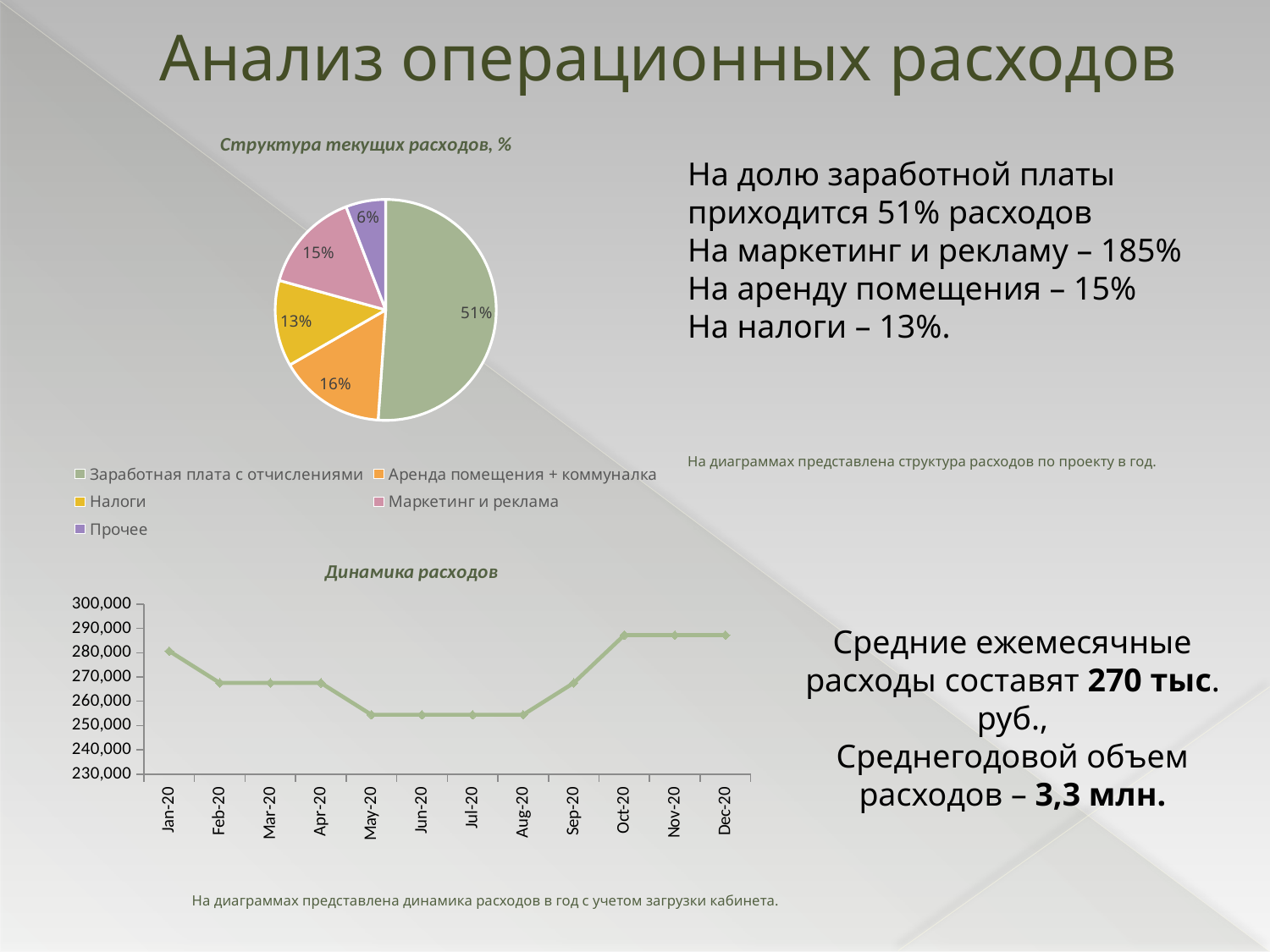
In the chart 'Динамика расходов', how many months are plotted on the x axis? 12 In the pie chart 'Структура текущих расходов, %', which category has the largest share? Заработная плата с отчислениями In the pie chart 'Структура текущих расходов, %', how many categories does the legend list? 5 What kind of chart is 'Динамика расходов'? Line chart In the chart 'Динамика расходов', is the value for Oct-20 greater or less than 280,000? greater In the chart 'Динамика расходов', is the value for May-20 greater or less than 260,000? less In the chart 'Динамика расходов', is the value for Dec-20 higher or lower than the value for Jul-20? higher In the pie chart 'Структура текущих расходов, %', which category has the smallest share? Прочее In the pie chart 'Структура текущих расходов, %', what is the difference between the shares of 'Аренда помещения + коммуналка' and 'Налоги'? 3% In the pie chart 'Структура текущих расходов, %', what share is shown for 'Аренда помещения + коммуналка'? 16% In the pie chart 'Структура текущих расходов, %', what share is shown for 'Маркетинг и реклама'? 15% In the pie chart 'Структура текущих расходов, %', what share is shown for 'Заработная плата с отчислениями'? 51%